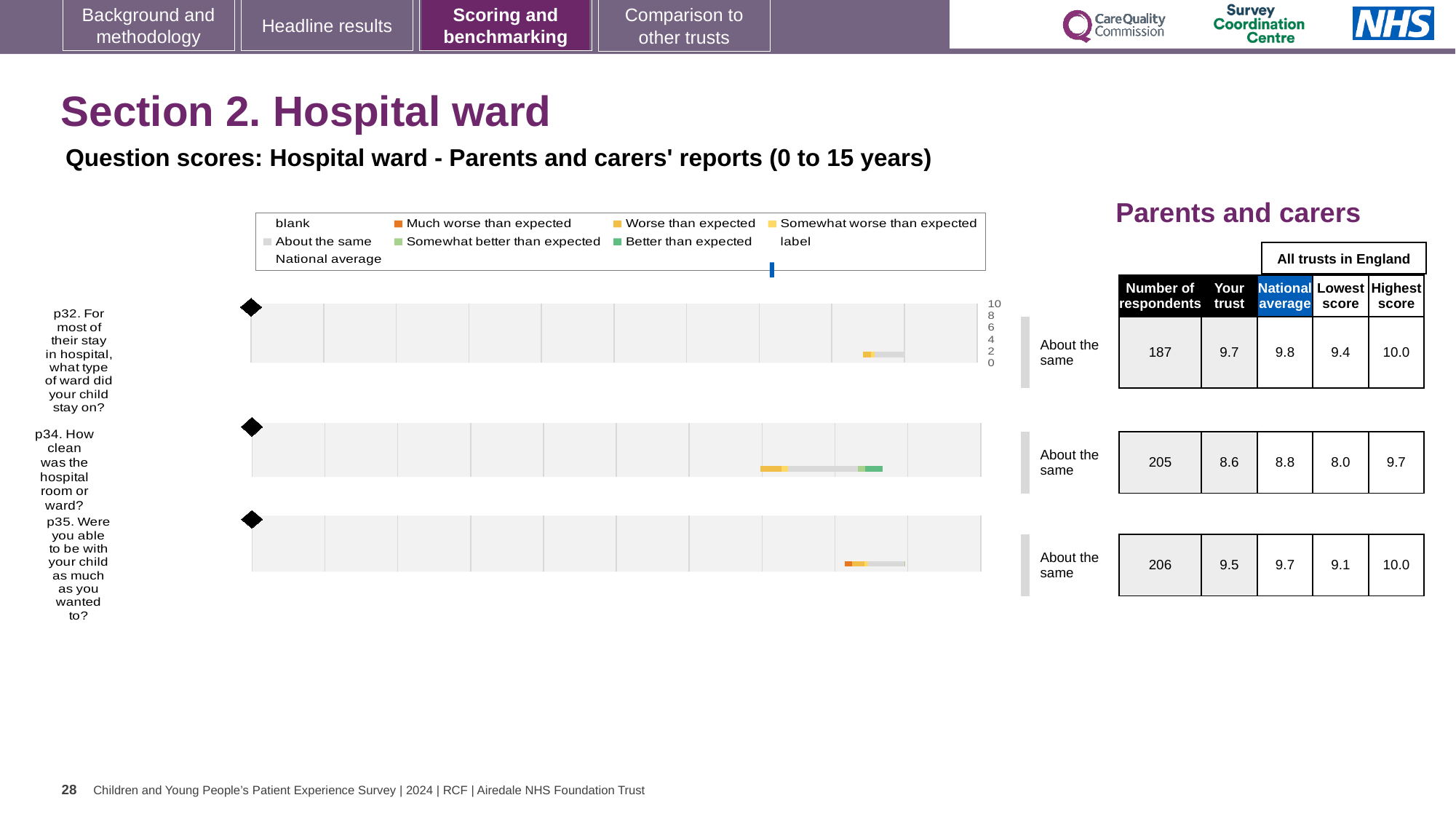
What is the lowest score among all trusts in England for p35? 9.1 Which question has the lowest 'Your trust' score? p34 What is the highest score among all trusts in England for p34? 9.7 What benchmark category is shown next to each of the three charts? About the same What is the national average score for p35 (Were you able to be with your child as much as you wanted to)? 9.7 What is the 'Your trust' score for p34 (How clean was the hospital room or ward?)? 8.6 For p35, which is larger: the 'Your trust' score or the national average? National average How many respondents answered p32 (what type of ward did your child stay on)? 187 How many questions (p32, p34, p35) have a chart on this slide? 3 For p34, what is the difference between the national average and the 'Your trust' score? 0.2 Which question has the highest 'Your trust' score? p32 What kind of chart is used to show the question scores on this slide? bar chart